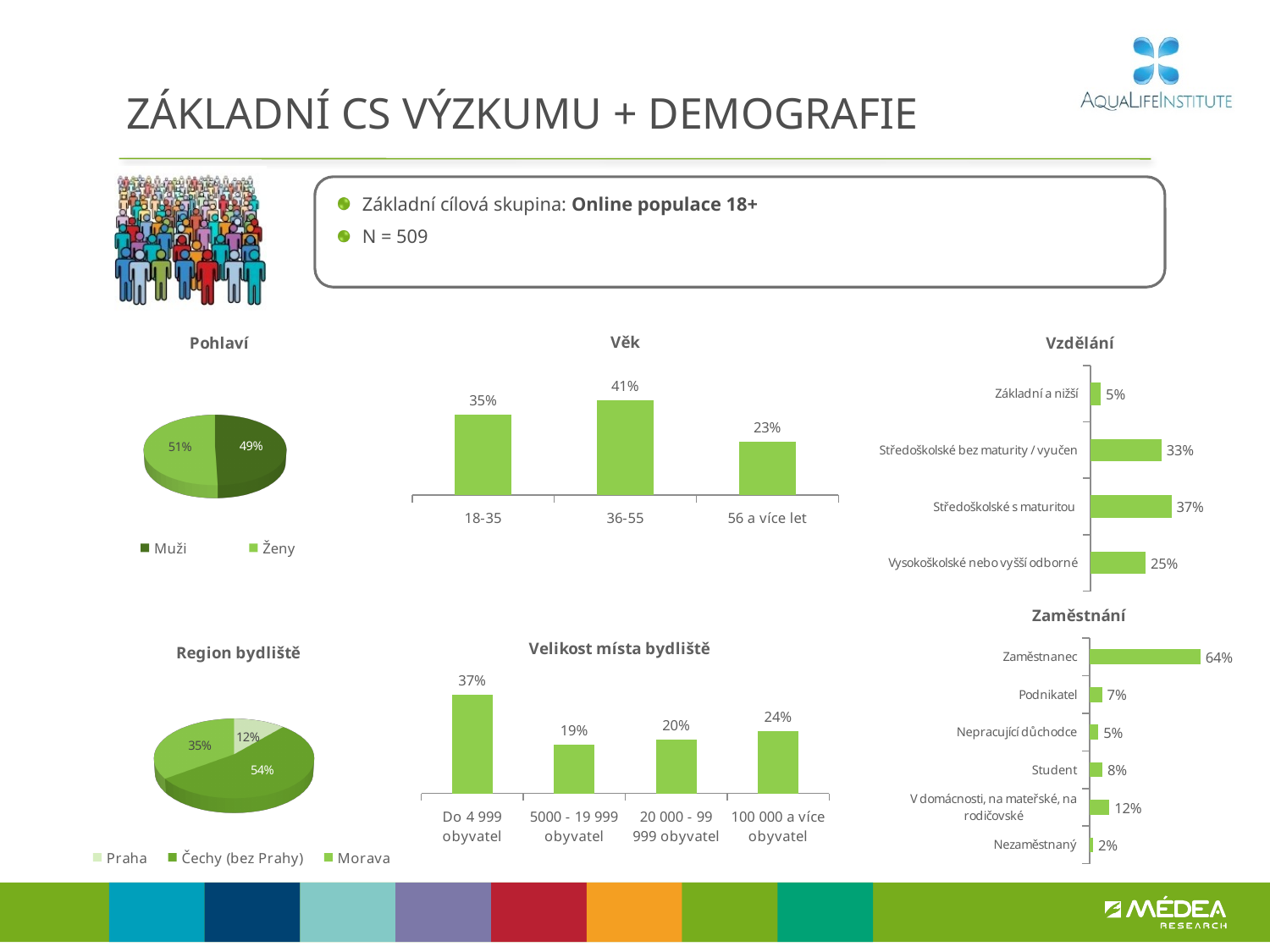
In the 'Vzdělání' chart, what is the difference between 'Středoškolské bez maturity / vyučen' and 'Základní a nižší'? 28% What type of chart is the 'Region bydliště' chart? Pie chart In the 'Věk' chart, which age group has the lowest value? 56 a více let How many categories does the 'Zaměstnání' chart show? 6 In the 'Zaměstnání' chart, what is the value for 'Student'? 8% In the 'Velikost místa bydliště' chart, which is larger: '5000 - 19 999 obyvatel' or '100 000 a více obyvatel'? 100 000 a více obyvatel In the 'Velikost místa bydliště' chart, what is the value for 'Do 4 999 obyvatel'? 37% In the 'Zaměstnání' chart, which category has the highest value? Zaměstnanec In the 'Věk' chart, what is the value for the 36-55 age group? 41% In the 'Vzdělání' chart, what is the value for 'Středoškolské s maturitou'? 37% In the 'Region bydliště' chart, what is the value for 'Praha'? 12% In the 'Pohlaví' chart, what share of the pie is 'Ženy'? 51%